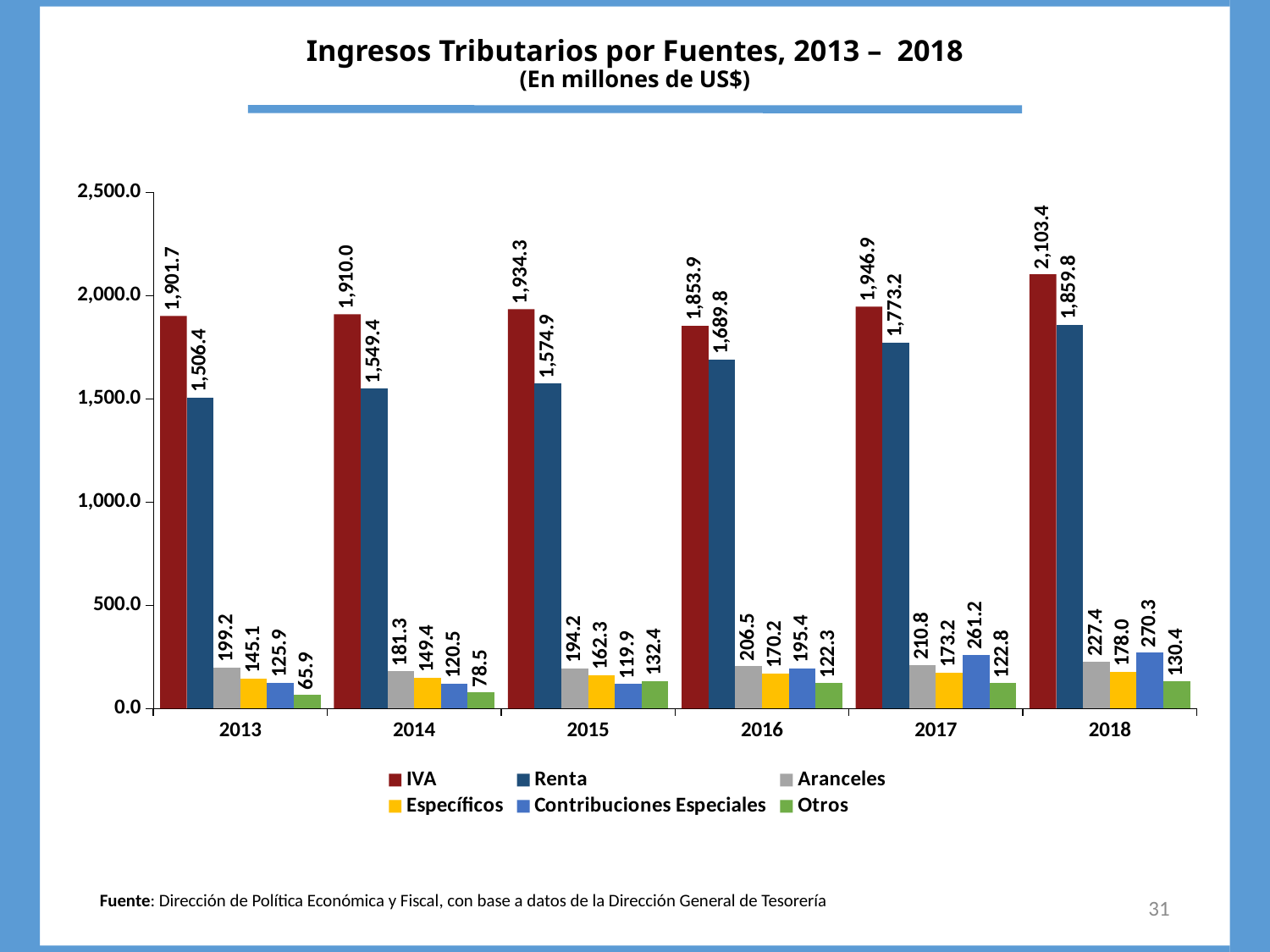
What is the Otros value for 2015? 132.4 What is the difference between the IVA and Renta values in 2016? 164.1 How many years are shown on the x axis? 6 What is the Renta value for 2013? 1,506.4 Which is larger in 2014: Aranceles or Específicos? Aranceles Does the Renta value rise or fall from 2013 to 2018? Rise How many series does the legend list? 6 In which year is the Otros value lowest? 2013 In which year is the IVA value highest? 2018 What is the Contribuciones Especiales value for 2017? 261.2 What kind of chart is shown? Bar chart What is the IVA value for 2018? 2,103.4